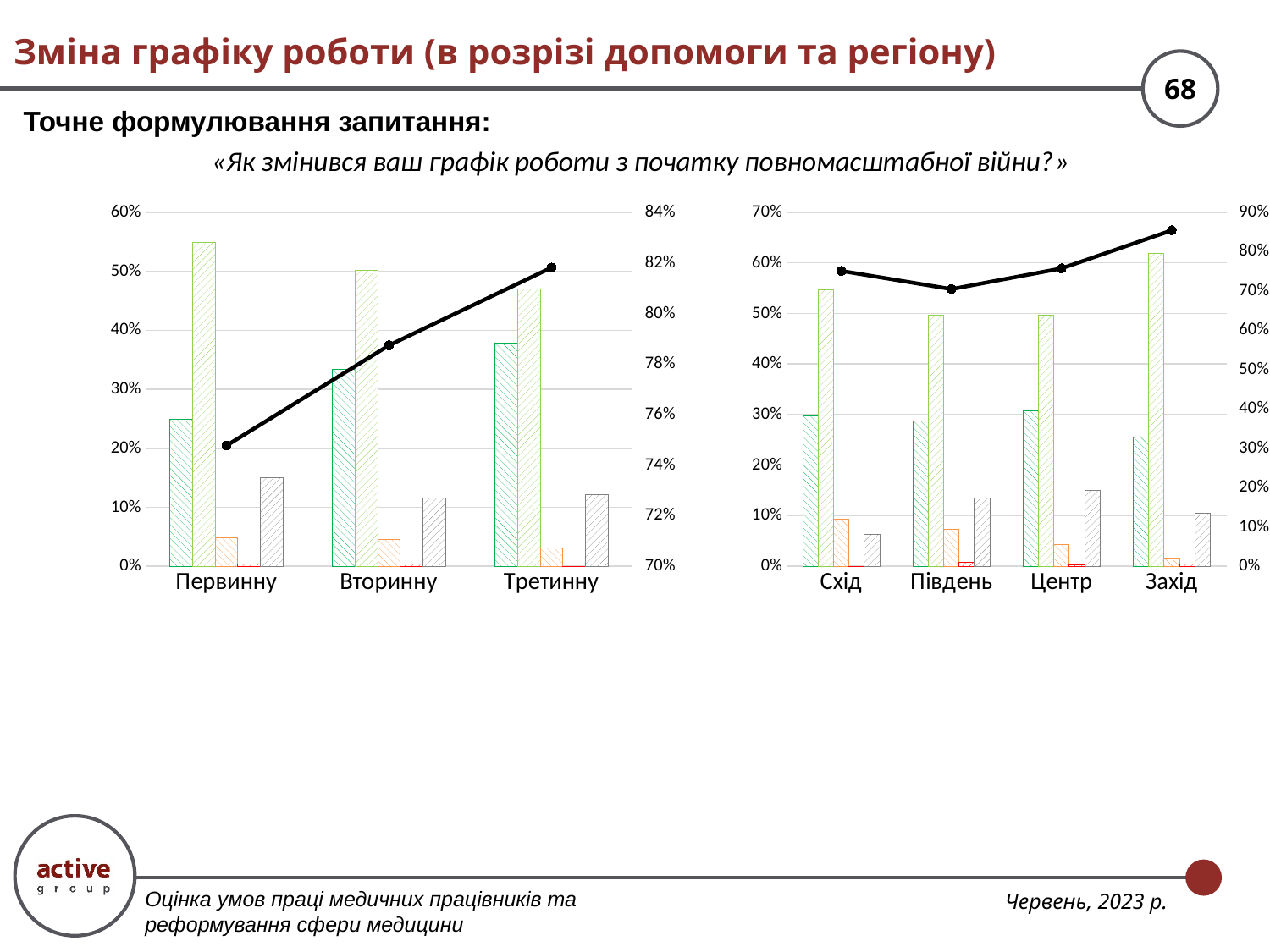
In the right chart, which region has the highest line value? Захід In the left chart, is the tallest bar for Первинну greater or less than 50%? greater In the right chart, which is larger: the line value for Схід or the line value for Південь? Схід How many categories are shown on the x axis of the right chart? 4 What kind of chart is the left chart? A bar chart combined with a line chart In the left chart, is the line value for Первинну (right axis) greater or less than 76%? less In the right chart, is the line value for Захід (right axis) greater or less than 80%? greater In the right chart, which region has the lowest line value? Південь In the left chart, does the line rise or fall from Первинну to Третинну? It rises How many categories are shown on the x axis of the left chart? 3